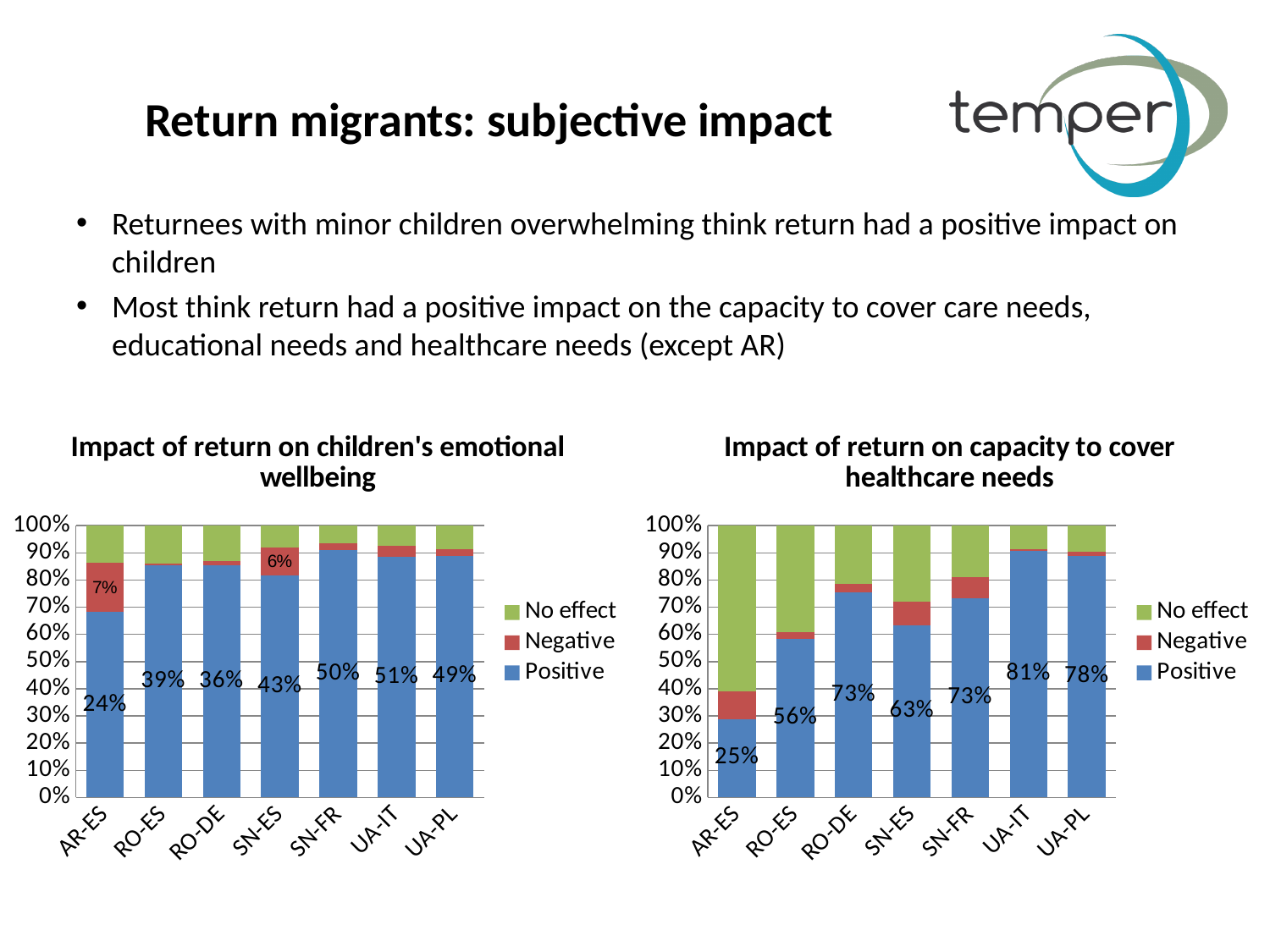
On the 'Impact of return on capacity to cover healthcare needs' chart, what data label is printed on the Positive segment for RO-ES? 56% On the 'Impact of return on capacity to cover healthcare needs' chart, which category has the smallest Positive segment? AR-ES On the 'Impact of return on capacity to cover healthcare needs' chart, which category has the largest No effect segment? AR-ES On the 'Impact of return on children's emotional wellbeing' chart, what data label is printed on the Negative segment for SN-ES? 6% On the 'Impact of return on capacity to cover healthcare needs' chart, what data label is printed on the Positive segment for UA-IT? 81% How many categories are shown on the x axis of the 'Impact of return on children's emotional wellbeing' chart? 7 Which series is shown in green in the legend of the 'Impact of return on children's emotional wellbeing' chart? No effect On the 'Impact of return on children's emotional wellbeing' chart, what data label is printed on the Positive segment for AR-ES? 24% On the 'Impact of return on capacity to cover healthcare needs' chart, is the top of the Positive segment for AR-ES greater or less than 40%? less What kind of chart is the 'Impact of return on children's emotional wellbeing' chart? Stacked bar chart On the 'Impact of return on children's emotional wellbeing' chart, which category has the largest Negative segment? AR-ES How many series does the legend list on the 'Impact of return on capacity to cover healthcare needs' chart? 3